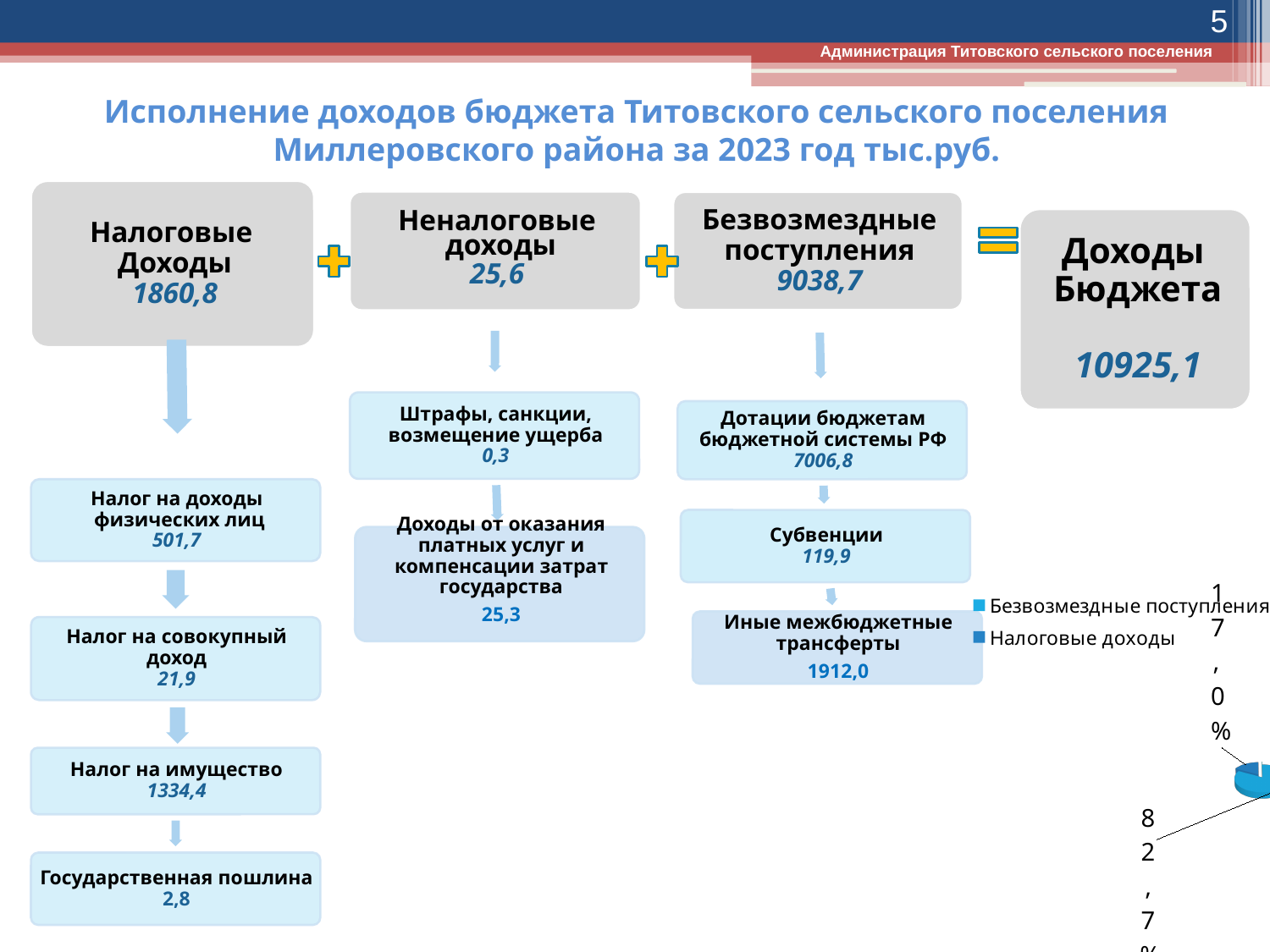
What kind of chart is shown in the bottom-right corner of the slide? pie chart What is the larger of the two percentage data labels shown on the pie chart in the bottom-right corner? 82,7% What is the first legend entry of the pie chart in the bottom-right corner? Безвозмездные поступления How many entries does the legend of the pie chart in the bottom-right corner list? 2 What is the smaller of the two percentage data labels shown on the pie chart in the bottom-right corner? 17,0% What is the second legend entry of the pie chart in the bottom-right corner? Налоговые доходы